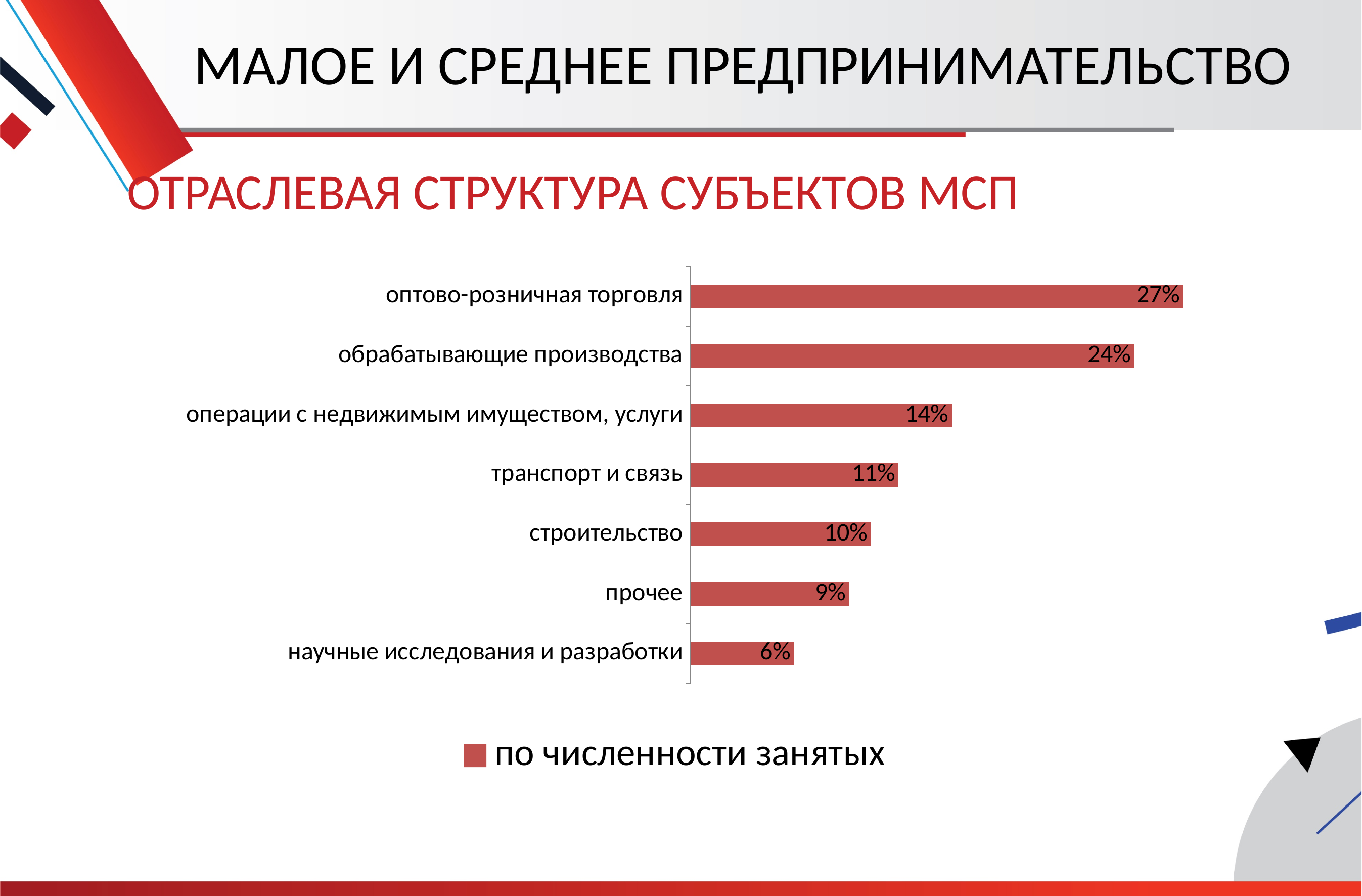
What is the value for транспорт и связь? 11% What is the difference between оптово-розничная торговля and обрабатывающие производства? 3% What is the value for оптово-розничная торговля? 27% What is the value for научные исследования и разработки? 6% Which category has the highest value? оптово-розничная торговля Which is larger: транспорт и связь or прочее? транспорт и связь What is the value for обрабатывающие производства? 24% Which category has the lowest value? научные исследования и разработки What is the legend entry of the series shown in the chart? по численности занятых What is the difference between операции с недвижимым имуществом, услуги and строительство? 4% What kind of chart is shown on the slide? bar chart How many categories are shown in the chart? 7